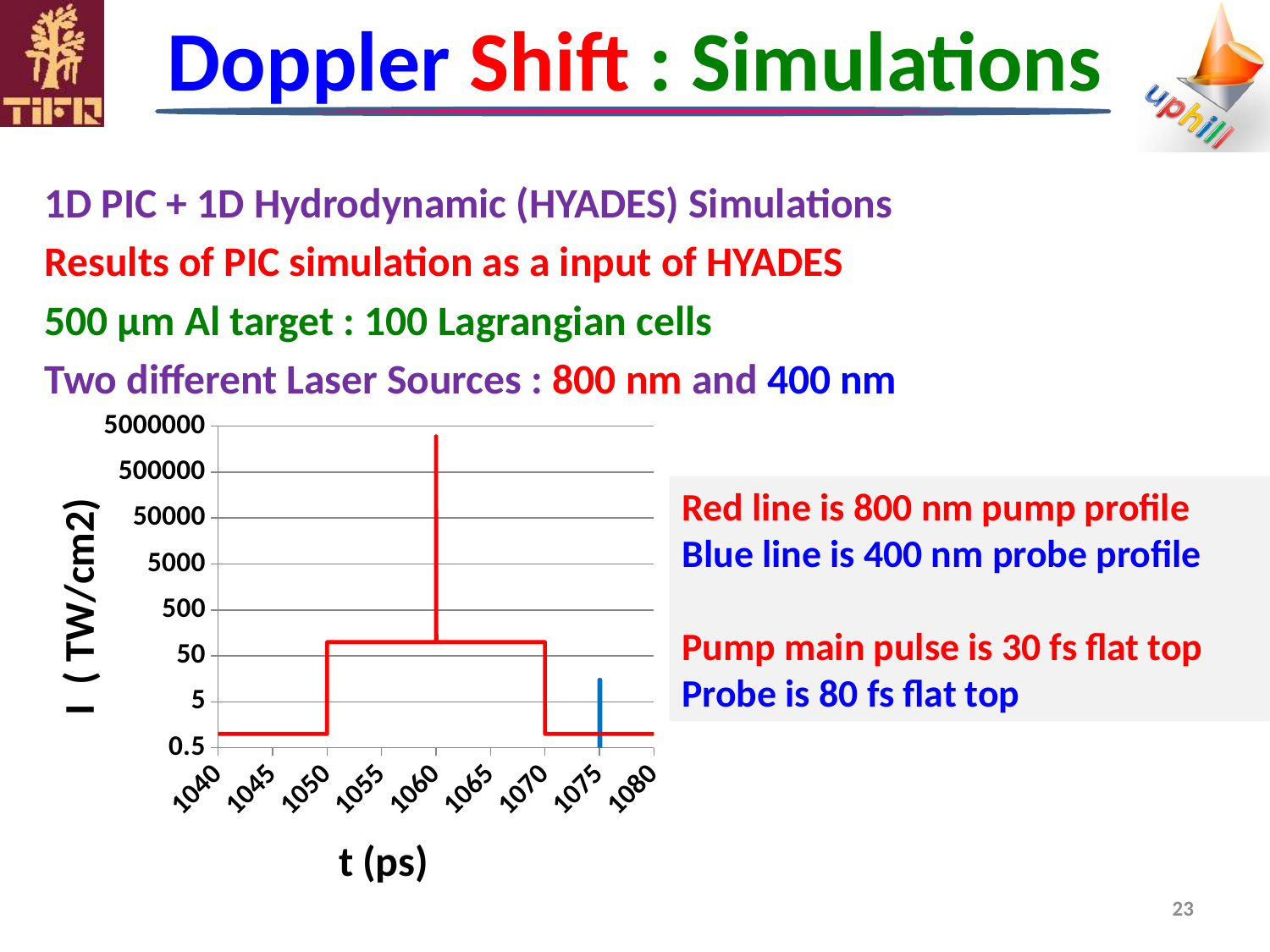
Is the value of the red line at t = 1055 ps greater or less than 500? less How many tick labels are shown on the x axis of the chart? 9 What kind of chart is shown on the slide? line chart Is the value of the red line at t = 1045 ps greater or less than 5? less Is the peak value of the red line greater or less than 500000? greater Which line reaches a higher peak intensity, the red line or the blue line? red line What is the label of the x axis of the chart? t (ps) What is the label of the y axis of the chart? I ( TW/cm2)